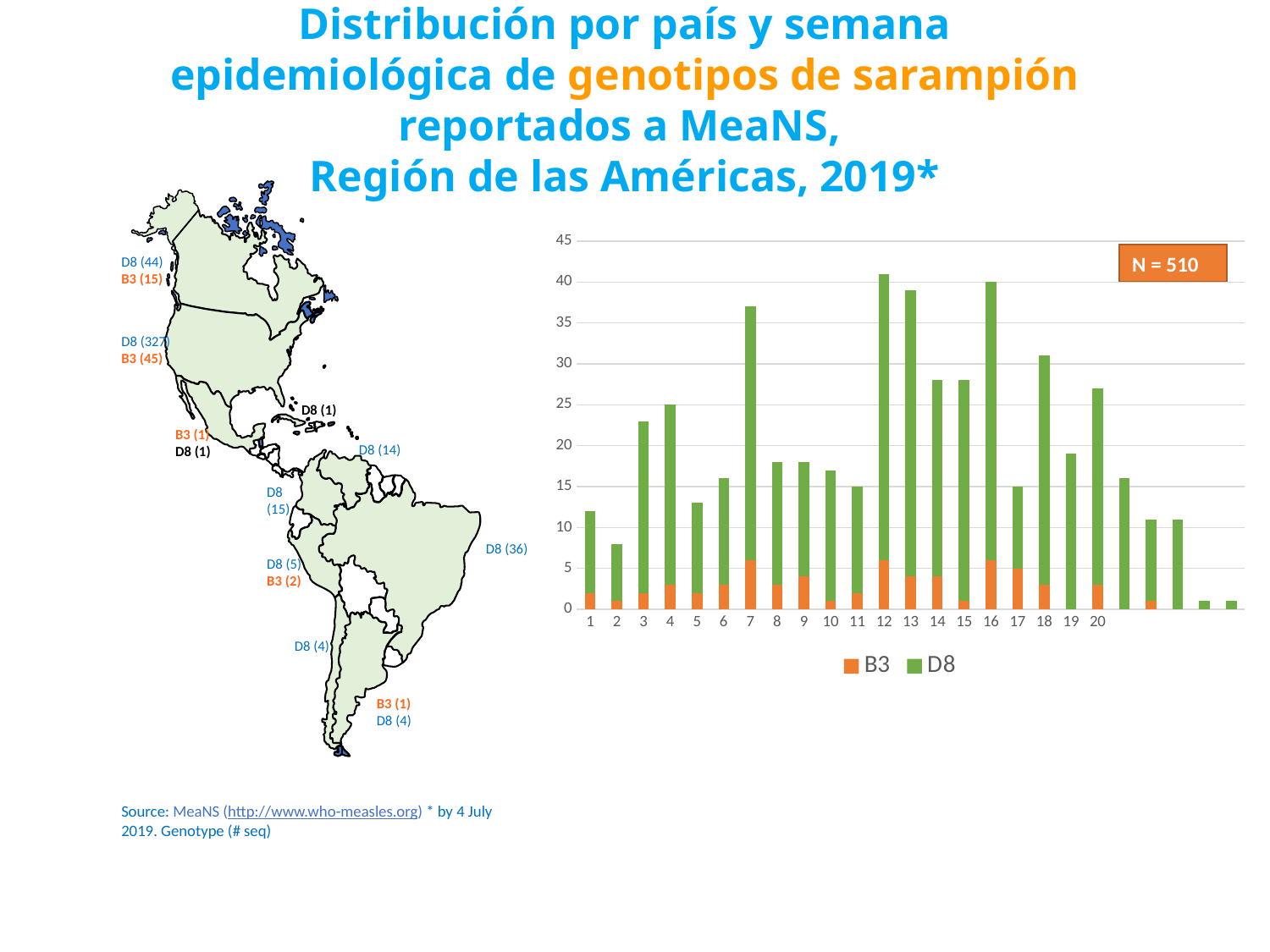
How many series does the legend of the bar chart list? 2 In the bar chart, is the total value for week 18 greater or less than 25? greater In the bar chart, is the total value for week 7 greater or less than 35? greater In the bar chart, is the total value for week 2 greater or less than 10? less In the bar chart, which has a larger total value, week 16 or week 17? week 16 What kind of chart is shown on the right side of the slide? bar chart Which two genotypes are listed in the legend of the bar chart? B3 and D8 What total N is shown in the box on the bar chart? N = 510 How many numbered week labels are shown on the x axis of the bar chart? 20 In the bar chart, which has a larger total value, week 7 or week 2? week 7